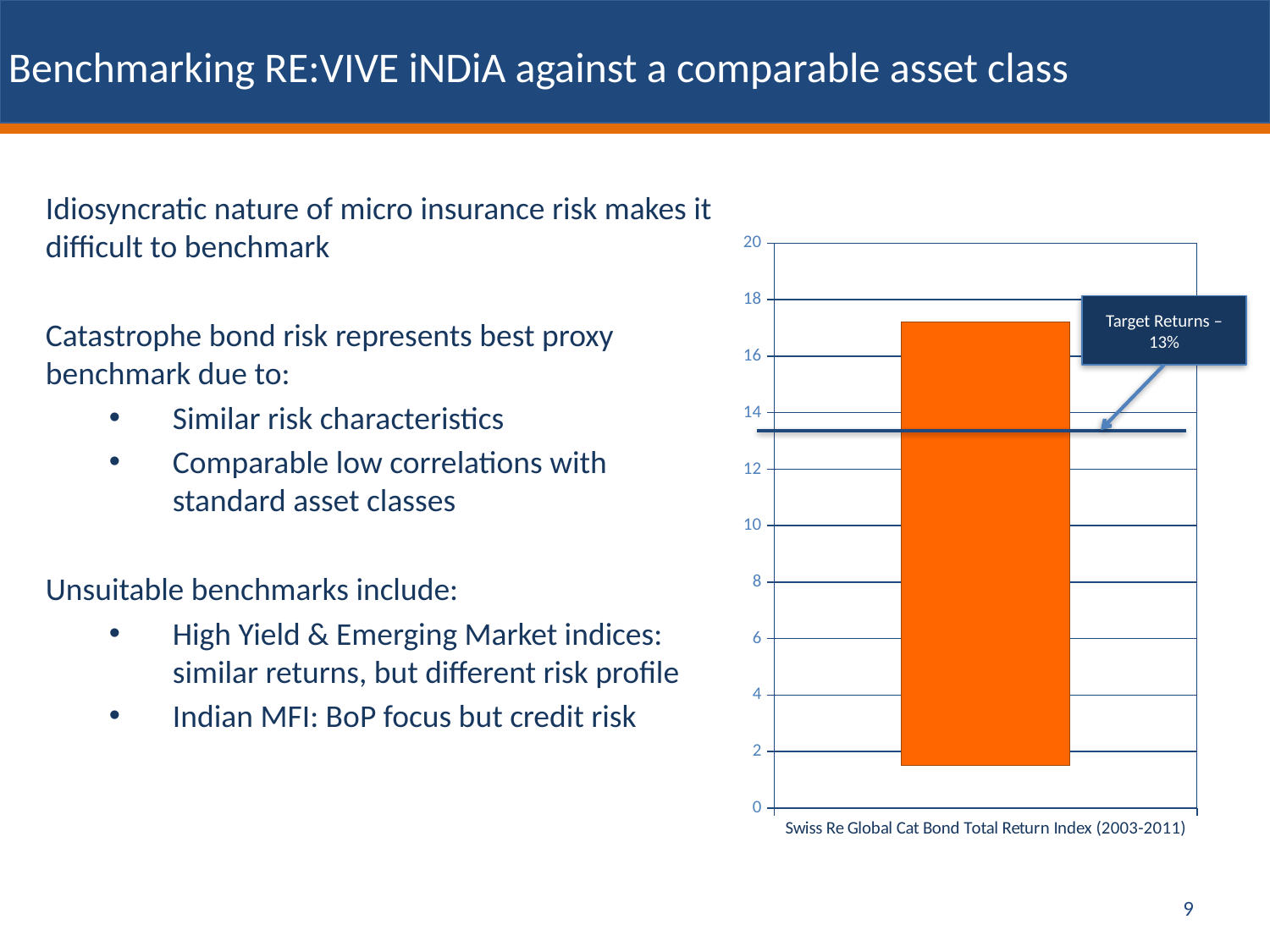
How many categories are shown on the x axis of the chart? 1 Is the top of the bar for the Swiss Re Global Cat Bond Total Return Index greater or less than 18? less Is the bottom of the bar for the Swiss Re Global Cat Bond Total Return Index greater or less than 2? less What does the annotation box on the chart say? Target Returns – 13% Is the horizontal target-return line on the chart greater or less than 12? greater What is the category label shown on the x axis of the chart? Swiss Re Global Cat Bond Total Return Index (2003-2011) What kind of chart is shown on the slide? bar chart What target return percentage is indicated on the chart? 13% What is the maximum value shown on the chart's vertical axis? 20